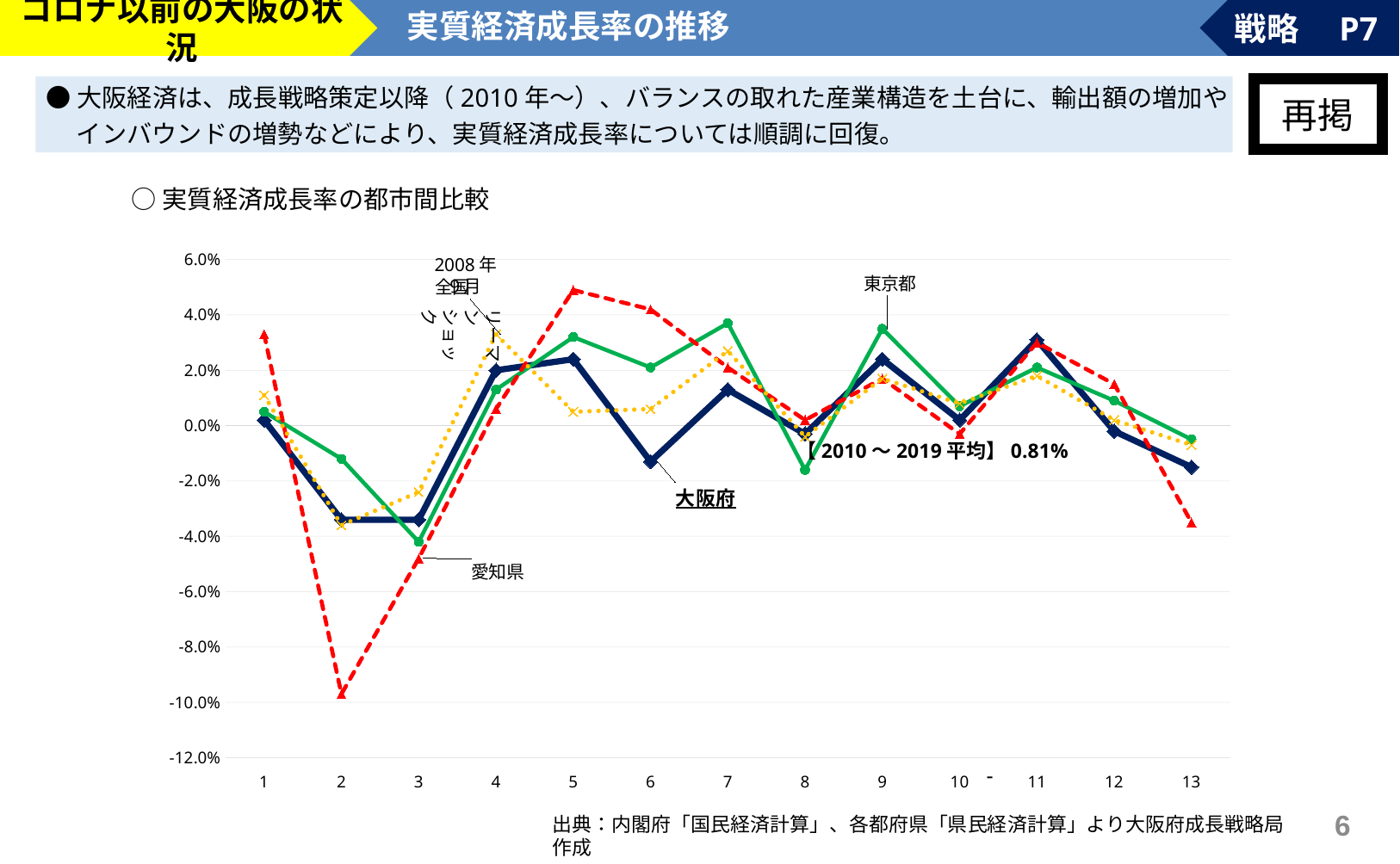
What kind of chart is shown on the slide? line chart Is the value for 愛知県 at point 5 greater or less than 4.0%? greater Is the value for 東京都 at point 7 greater or less than 2.0%? greater Which series has the lowest value at point 2? 愛知県 How many points are there along the x axis of the chart? 13 Is the value for 愛知県 at point 2 greater or less than -8.0%? less At point 8, which is larger: the value for 大阪府 or the value for 東京都? 大阪府 Which series reaches the highest value anywhere on the chart? 愛知県 What is the 2010–2019 average value printed on the chart? 0.81% Which series is drawn as a red dashed line? 愛知県 Does the value for 大阪府 rise or fall from point 11 to point 13? fall